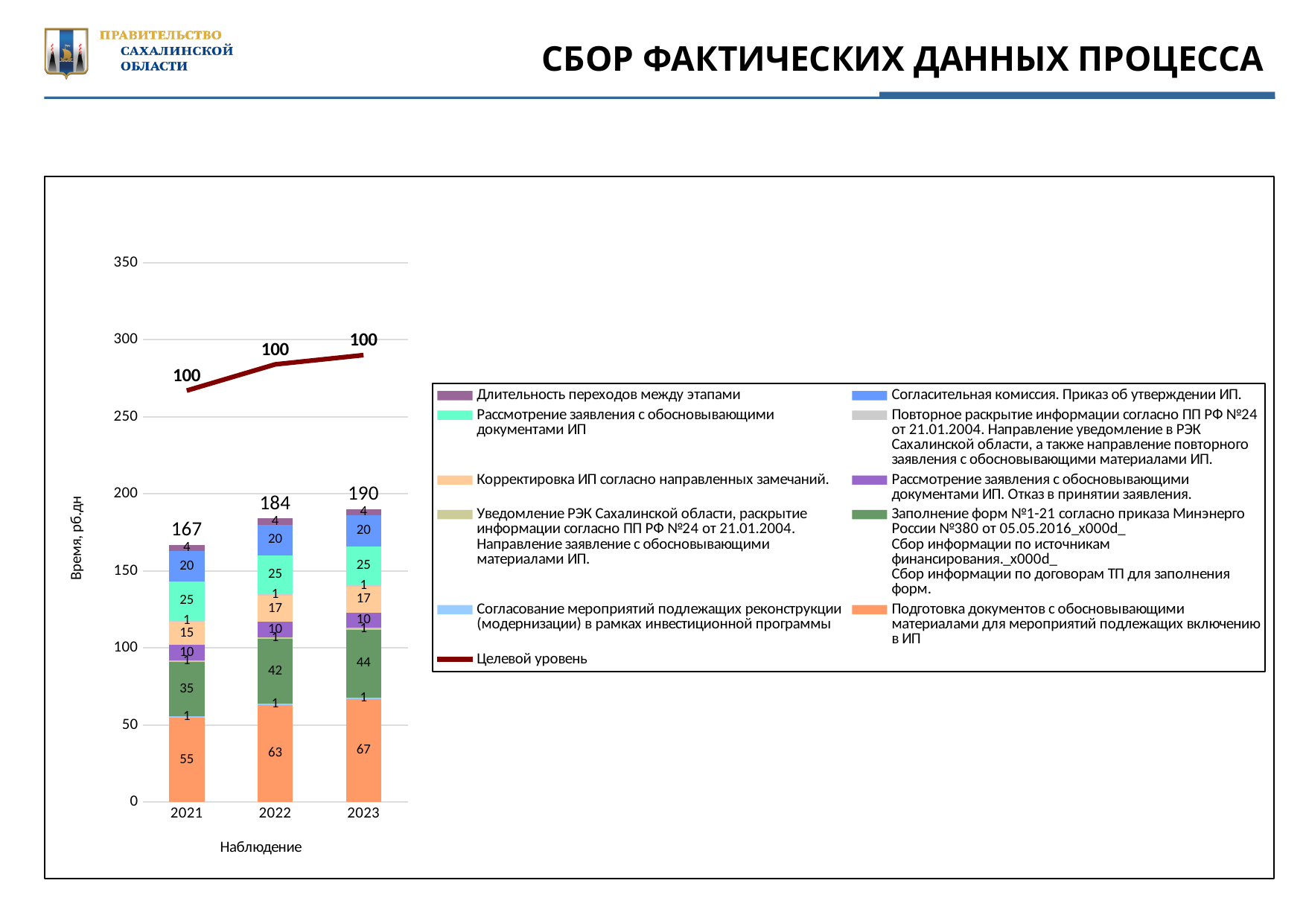
What kind of chart is shown on the slide? Stacked bar chart with a line What is the difference between the stacked bar totals for 2023 and 2021? 23 Which year has the larger value for the 'Подготовка документов с обосновывающими материалами' segment, 2021 or 2023? 2023 What is the labelled value of the 'Целевой уровень' line for 2022? 100 What is the value of the 'Заполнение форм №1-21 согласно приказа Минэнерго России №380' segment for 2023? 44 What is the total height of the stacked bar for 2021? 167 Which year has the lowest stacked bar total? 2021 What is the value of the 'Подготовка документов с обосновывающими материалами для мероприятий подлежащих включению в ИП' segment for 2022? 63 Which year has the highest stacked bar total? 2023 How many entries does the legend list? 11 Do the stacked bar totals rise or fall from 2021 to 2023? Rise How many years (categories) are shown on the x axis? 3